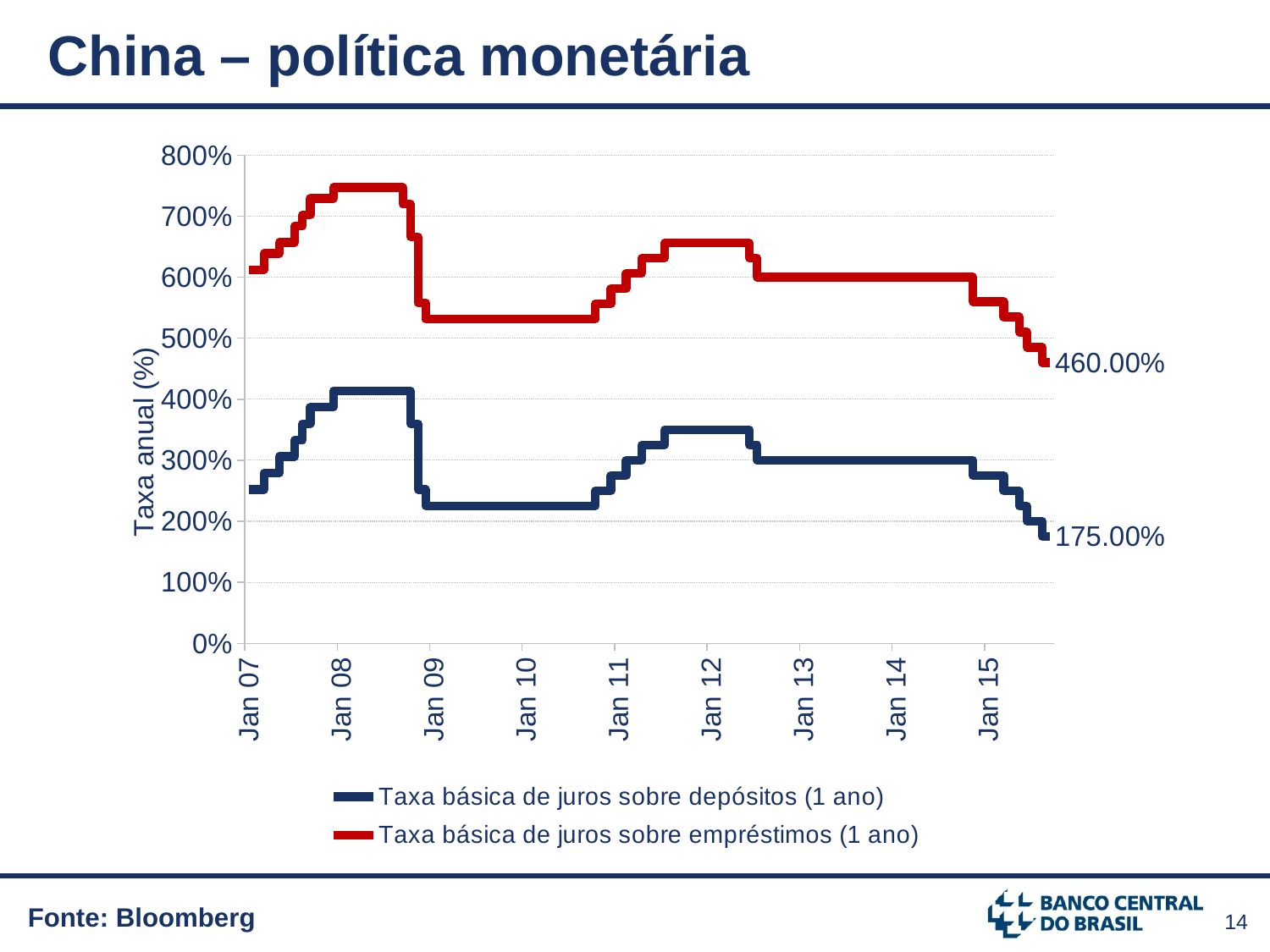
Is the peak of the lending rate series (red) in 2008 greater or less than 700%? greater What source is cited for the chart? Bloomberg What is the last labelled value of the series 'Taxa básica de juros sobre empréstimos (1 ano)'? 460.00% Does the deposit rate series rise or fall between Jan 15 and the end of the chart? fall What is the last labelled value of the series 'Taxa básica de juros sobre depósitos (1 ano)'? 175.00% Which series has the higher value at the end of the chart, depósitos or empréstimos? Taxa básica de juros sobre empréstimos (1 ano) Is the value of the deposit rate series (blue) at Jan 09 greater or less than 300%? less What is the title of the vertical axis? Taxa anual (%) How many series does the legend list? 2 Is the value of the lending rate series (red) at Jan 10 greater or less than 500%? greater What is the difference between the final labelled values of the lending rate (460.00%) and the deposit rate (175.00%)? 285.00% What kind of chart is shown on the slide? line chart